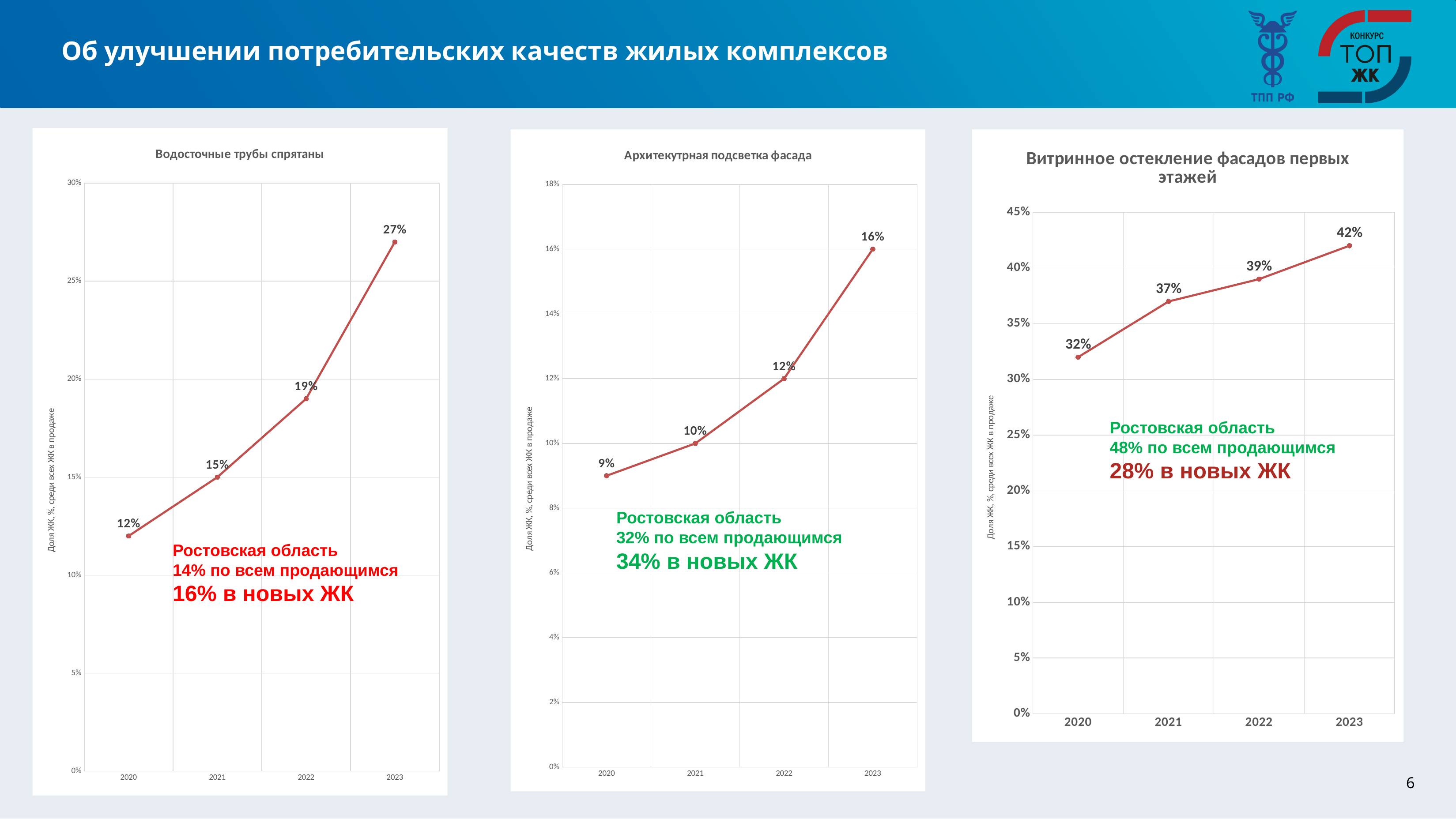
In the chart titled "Витринное остекление фасадов первых этажей", do the values rise or fall from 2020 to 2023? rise In the chart titled "Водосточные трубы спрятаны", what is the value for 2020? 12% In the chart titled "Водосточные трубы спрятаны", what is the difference between the 2023 and 2020 values? 15% In the chart titled "Витринное остекление фасадов первых этажей", which year has the highest value? 2023 In the chart titled "Водосточные трубы спрятаны", which is larger, the value for 2021 or the value for 2022? 2022 In the chart titled "Витринное остекление фасадов первых этажей", how many data points are plotted? 4 In the chart titled "Архитекутрная подсветка фасада", what is the value for 2022? 12% In the chart titled "Архитекутрная подсветка фасада", which year has the lowest value? 2020 In the chart titled "Архитекутрная подсветка фасада", what is the difference between the 2023 and 2022 values? 4% In the chart titled "Водосточные трубы спрятаны", what is the value for 2023? 27% What kind of chart is the chart titled "Водосточные трубы спрятаны"? line chart In the chart titled "Витринное остекление фасадов первых этажей", what is the value for 2021? 37%